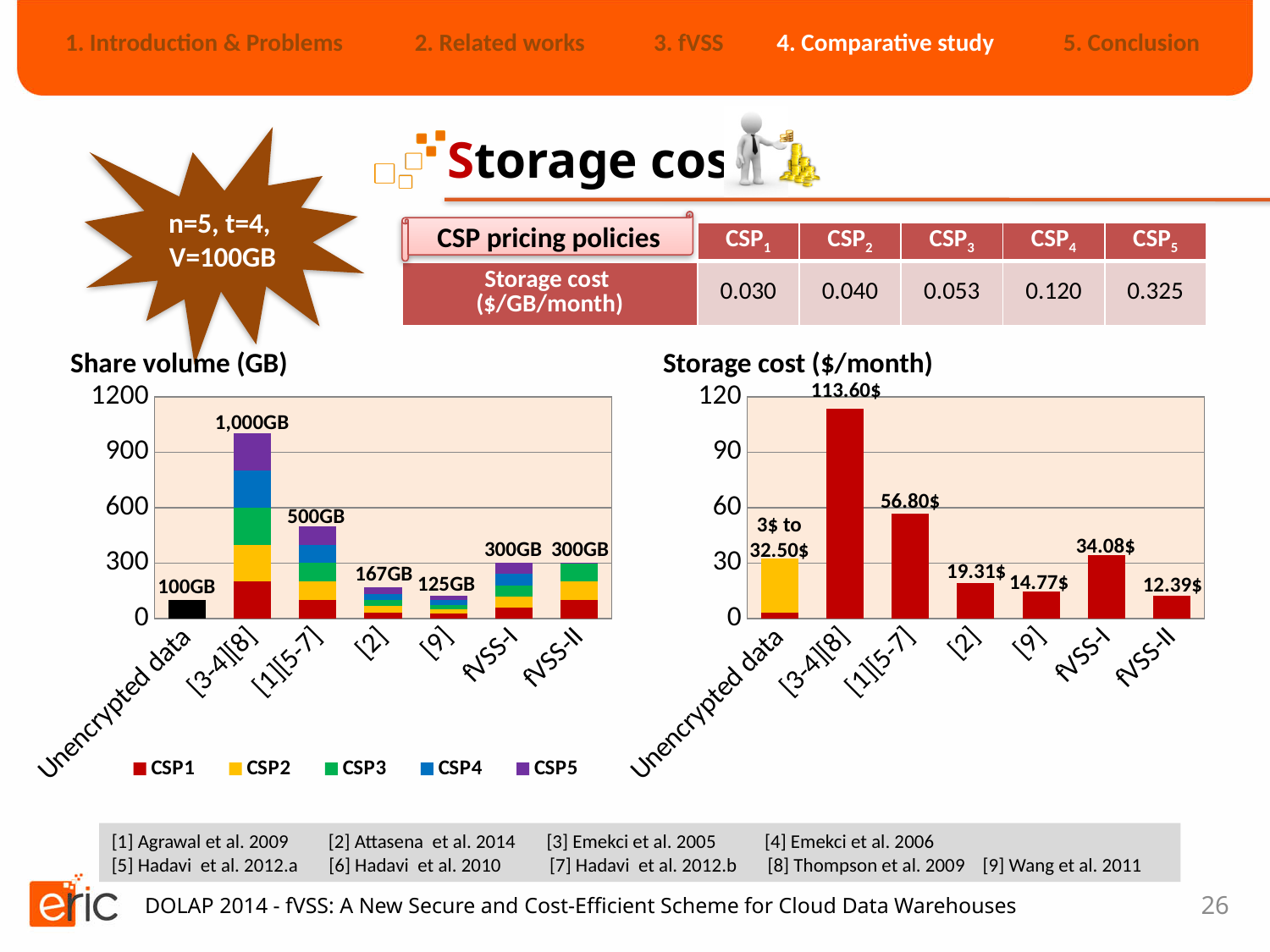
What kind of chart is the Storage cost ($/month) chart? Bar chart In the Storage cost ($/month) chart, how many categories are shown on the x axis? 7 In the Share volume (GB) chart, how many series does the legend list? 5 In the Storage cost ($/month) chart, what is the storage cost for [3-4][8]? 113.60$ In the Storage cost ($/month) chart, what is the storage cost for fVSS-II? 12.39$ In the Share volume (GB) chart, what is the difference between the total for [1][5-7] and the total for [9]? 375GB In the Share volume (GB) chart, which category has the highest total share volume? [3-4][8] In the Share volume (GB) chart, what is the total share volume for [3-4][8]? 1,000GB In the Storage cost ($/month) chart, which is larger, the cost for fVSS-I or the cost for [2]? fVSS-I In the Share volume (GB) chart, what is the total share volume for [2]? 167GB In the Share volume (GB) chart, which category has the lowest total share volume? Unencrypted data In the Storage cost ($/month) chart, what is the difference between the cost for [1][5-7] and the cost for fVSS-I? 22.72$